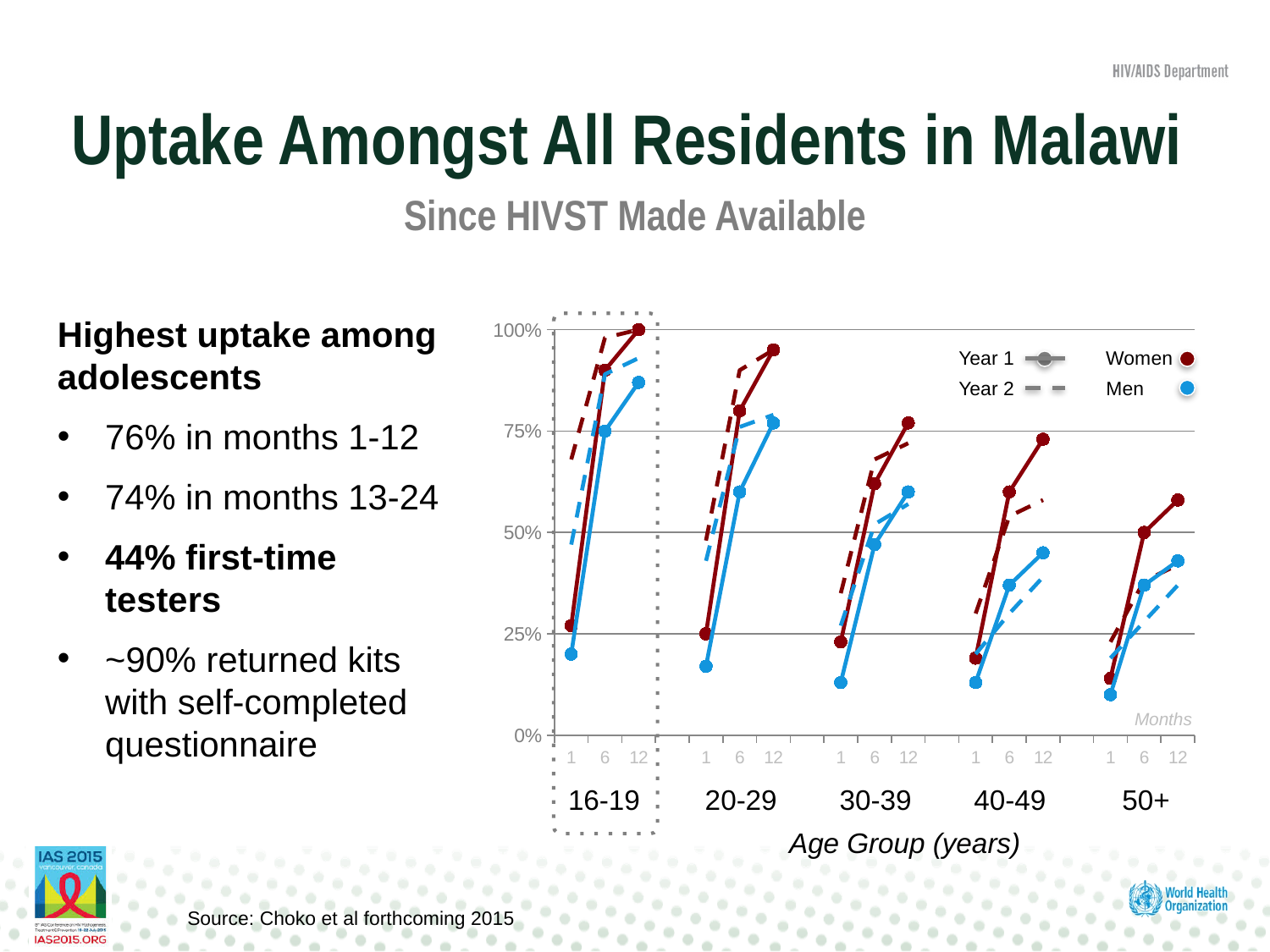
Is the Year 1 value for men at month 12 in the 30-39 age group greater or less than 75%? less Do the Year 1 values for women rise or fall from month 1 to month 12 within each age group? rise Is the Year 1 value for men at month 1 in the 50+ age group greater or less than 25%? less Which age group is highlighted with a dotted box on the chart? 16-19 Is the Year 1 value for women at month 12 in the 16-19 age group greater or less than 75%? greater In the 20-29 age group, which Year 1 series is higher at month 12, women or men? women What kind of chart is shown on the slide? line chart How many age groups are shown along the x axis of the chart? 5 What is the label of the x axis of the chart? Age Group (years) How many entries does the chart legend list? 4 Which age group has the highest Year 1 value for women at month 12? 16-19